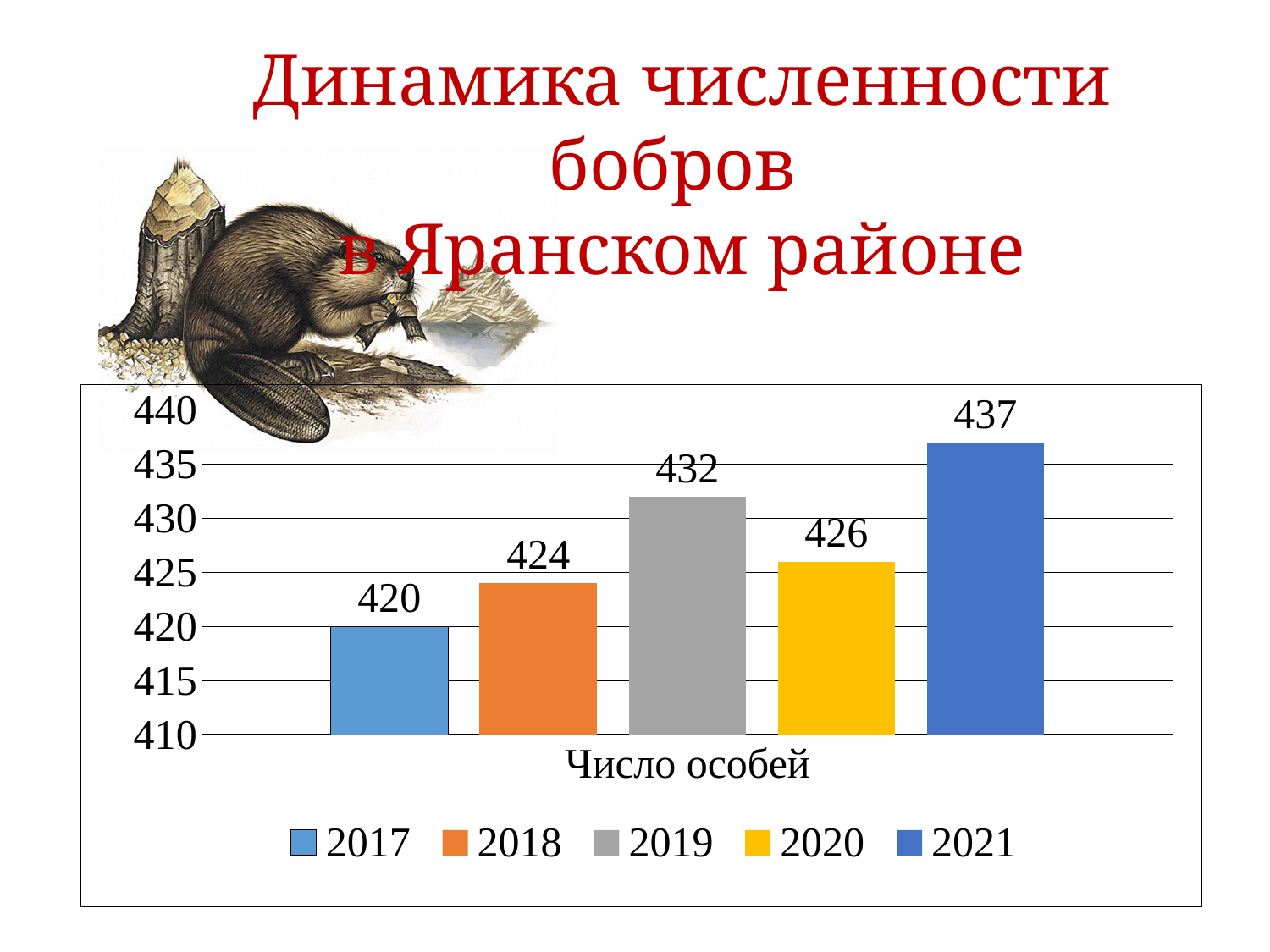
What is the value shown for 2021? 437 How many series does the legend list? 5 Is the value for 2019 greater or less than 430? greater Which is larger, the value for 2018 or the value for 2020? 2020 What kind of chart is shown on the slide? bar chart What is the difference between the values for 2019 and 2020? 6 What is the value shown for 2019? 432 What is the label on the x axis of the chart? Число особей Which year has the highest value? 2021 What is the difference between the values for 2021 and 2017? 17 Which year has the lowest value? 2017 What is the number of beavers (Число особей) for 2017? 420